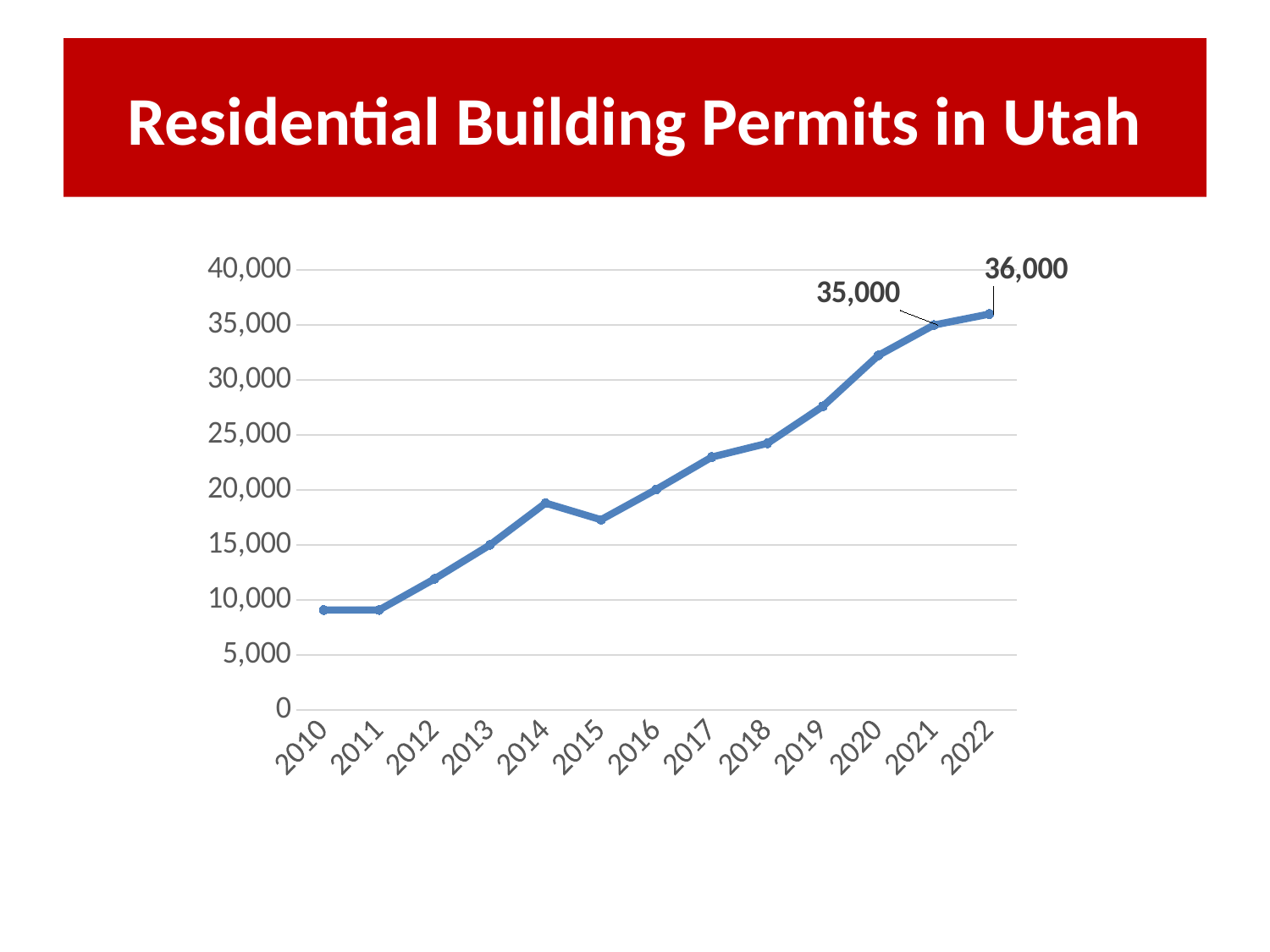
Is the value for 2020 greater or less than 30,000? greater What is the title of the chart? Residential Building Permits in Utah Do the values generally rise or fall from 2010 to 2022? Rise What is the value for 2022? 36,000 What is the difference between the values for 2022 and 2021? 1,000 How many years are plotted on the x axis? 13 What type of chart is shown on the slide? Line chart Is the value for 2014 greater or less than 20,000? less Is the value for 2010 greater or less than 10,000? less Which year has the larger value, 2014 or 2015? 2014 What is the value for 2021? 35,000 Which year has the highest value? 2022